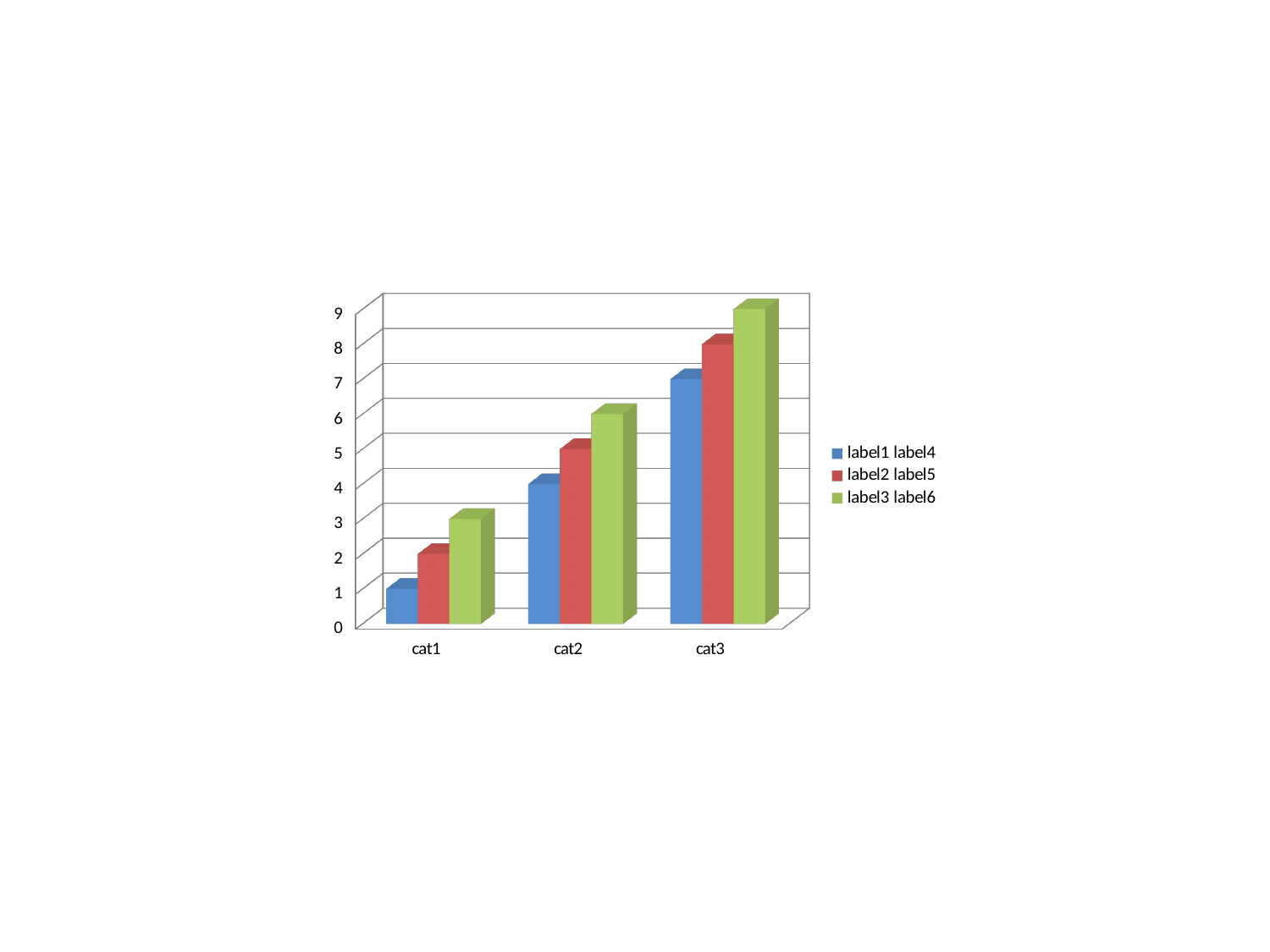
Which category has the lowest value for the series label1 label4? cat1 Is the value for label1 label4 in cat3 greater or less than 5? greater What is the highest value shown on the vertical axis? 9 How many series does the legend list? 3 Do the values for label2 label5 rise or fall from cat1 to cat3? rise Which category has the highest value for the series label3 label6? cat3 In cat2, which series has the larger value: label1 label4 or label3 label6? label3 label6 Which series is shown in green in the legend? label3 label6 Is the value for label2 label5 in cat1 greater or less than 4? less How many categories are shown on the x axis? 3 Is the value for label3 label6 in cat2 greater or less than 4? greater What kind of chart is shown on the slide? bar chart